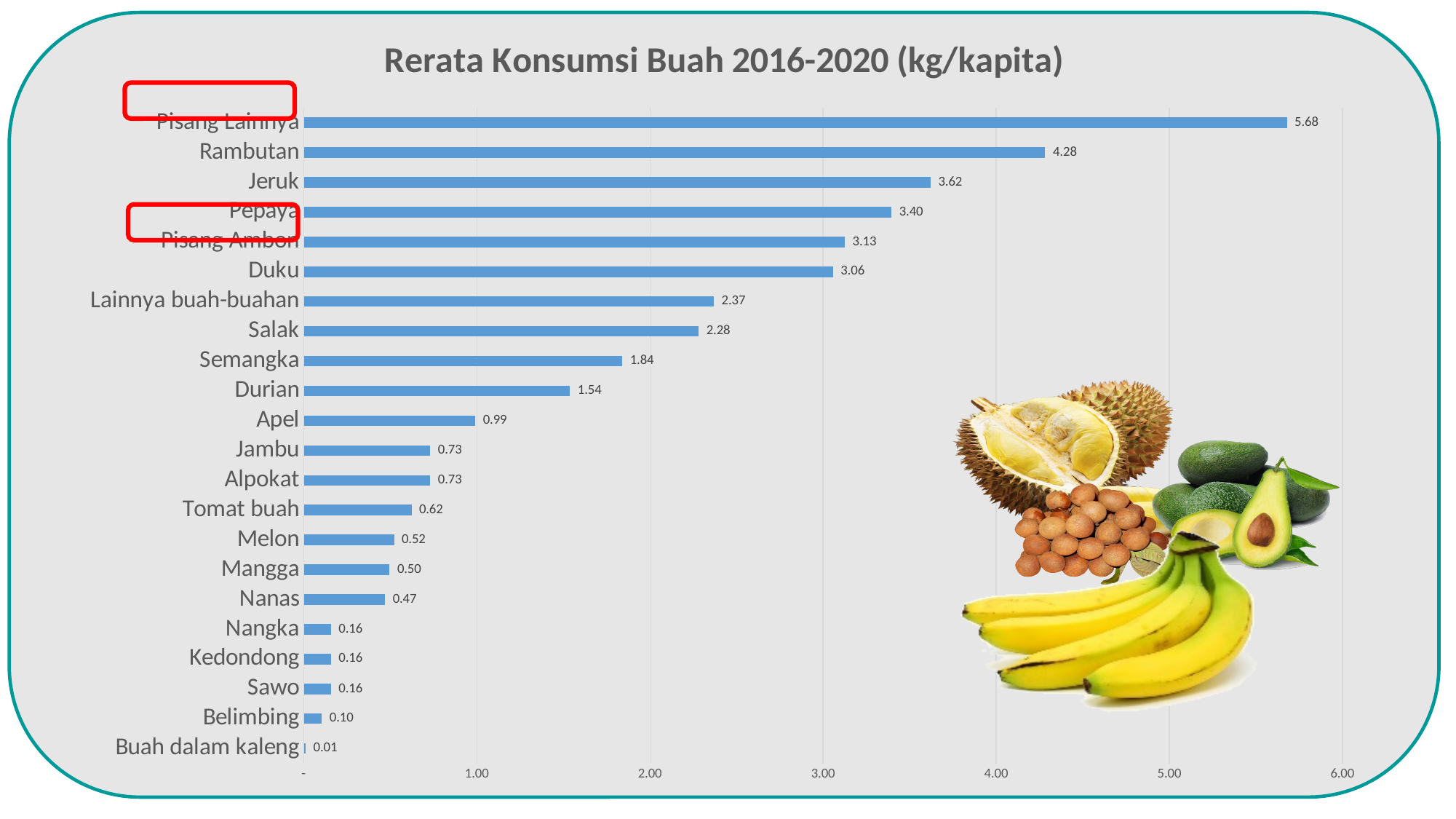
Is the value for Jeruk greater or less than 3.00? greater What kind of chart is shown on the slide? Bar chart What is the title of the chart? Rerata Konsumsi Buah 2016-2020 (kg/kapita) What is the value for Buah dalam kaleng? 0.01 Which is larger, the value for Salak or the value for Apel? Salak Which category has the lowest value? Buah dalam kaleng What is the difference between the values for Semangka and Durian? 0.30 What is the value for Durian? 1.54 Which category has the highest value? Pisang Lainnya What is the difference between the values for Pisang Lainnya and Rambutan? 1.40 What is the value for Rambutan? 4.28 How many categories are shown in the chart? 22